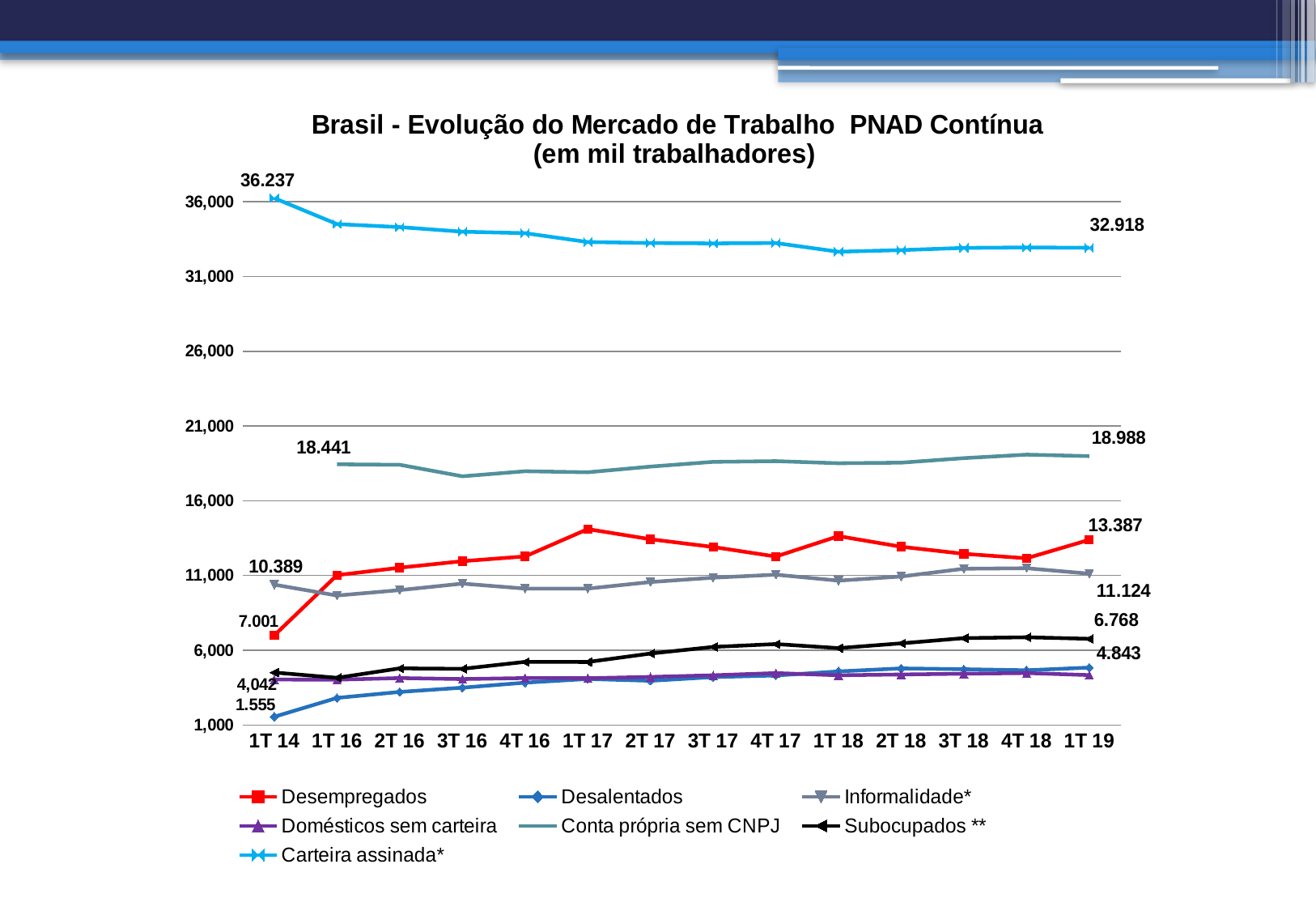
What is the value for Conta própria sem CNPJ in 1T 19? 18.988 What is the value for Carteira assinada* in 1T 19? 32.918 Does the Carteira assinada* line rise or fall from 1T 14 to 1T 19? fall What kind of chart is shown on the slide? line chart What is the value for Desempregados in 1T 19? 13.387 What is the value for Carteira assinada* in 1T 14? 36.237 How many series does the legend list? 7 Which series has the lowest value in 1T 14? Desalentados By how much did Desempregados increase from 1T 14 (7.001) to 1T 19 (13.387)? 6.386 How many quarters are shown on the x axis? 14 Is the value for Subocupados ** in 1T 14 greater or less than 6,000? less Which series has the highest value in 1T 19? Carteira assinada*